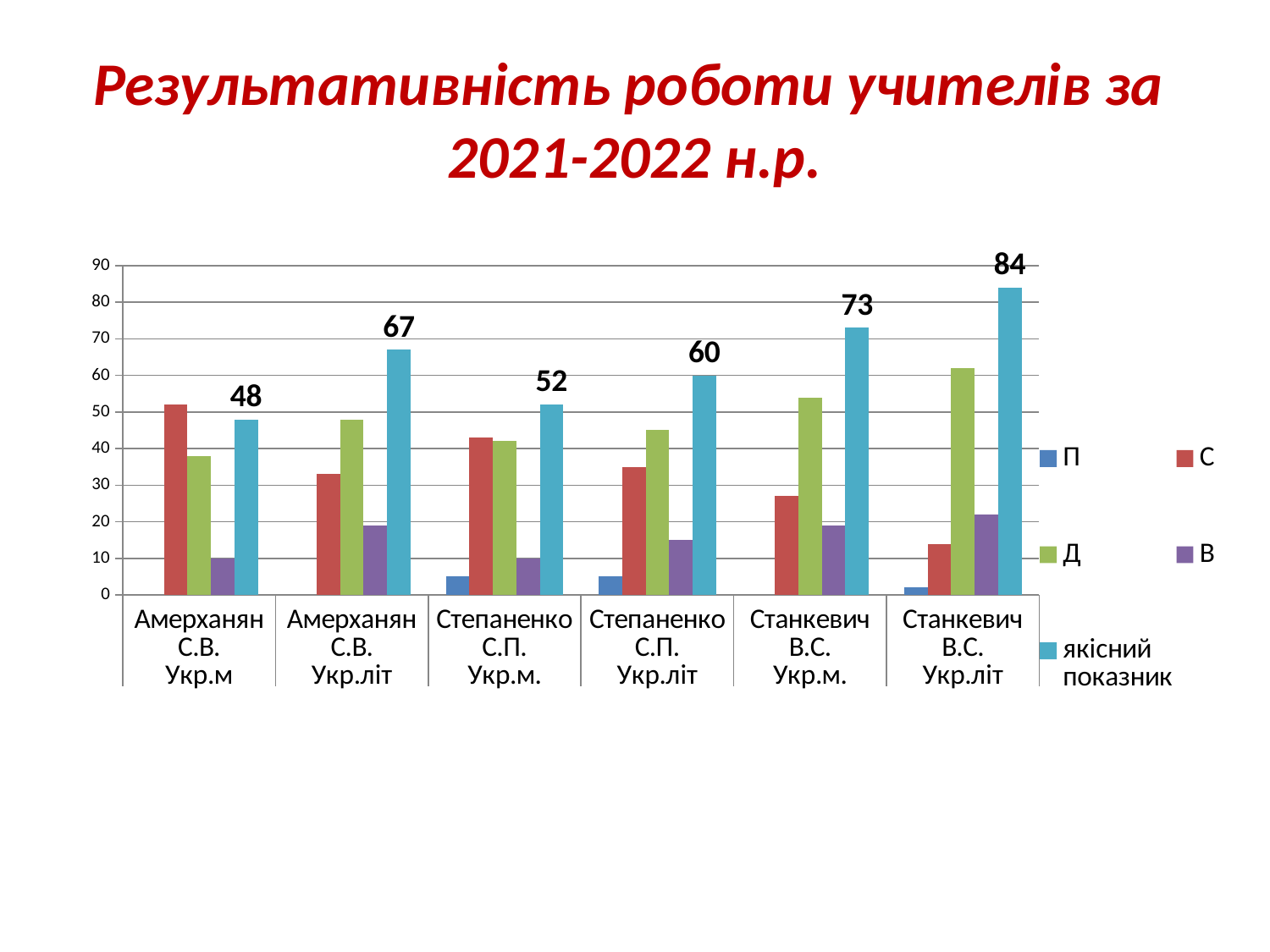
What is the якісний показник value for Степаненко С.П. Укр.літ? 60 Which is larger: the якісний показник for Амерханян С.В. Укр.літ or for Степаненко С.П. Укр.літ? Амерханян С.В. Укр.літ Which category has the lowest якісний показник? Амерханян С.В. Укр.м Is the value of the С series for Амерханян С.В. Укр.м greater or less than 40? greater How many categories are shown on the x axis? 6 What is the якісний показник value for Амерханян С.В. Укр.м? 48 What is the difference between the якісний показник for Станкевич В.С. Укр.м. and Степаненко С.П. Укр.м.? 21 What type of chart is shown on the slide? bar chart How many series does the legend list? 5 What is the якісний показник value for Станкевич В.С. Укр.літ? 84 Is the value of the Д series for Станкевич В.С. Укр.літ greater or less than 50? greater Which category has the highest якісний показник? Станкевич В.С. Укр.літ